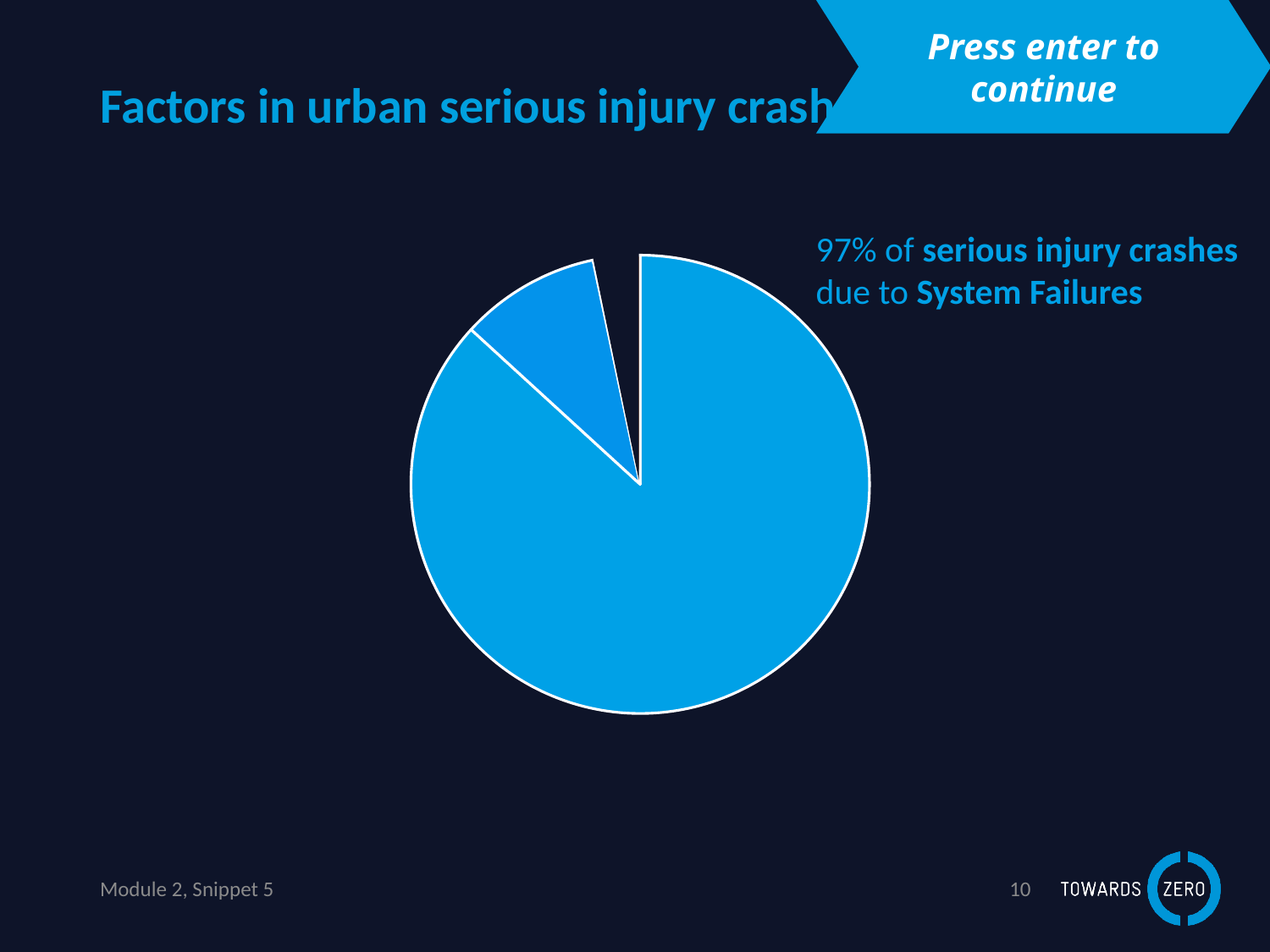
Is the share of serious injury crashes due to System Failures greater or less than 50%? greater How many slices does the pie chart have? 3 What factor does the slide say accounts for 97% of serious injury crashes? System Failures According to the slide, what share of serious injury crashes is due to System Failures? 97% What kind of chart is shown on the slide? pie chart Which slice of the pie chart is larger, the lighter blue slice or the darker blue slice? the lighter blue slice Does the pie chart have a legend? No